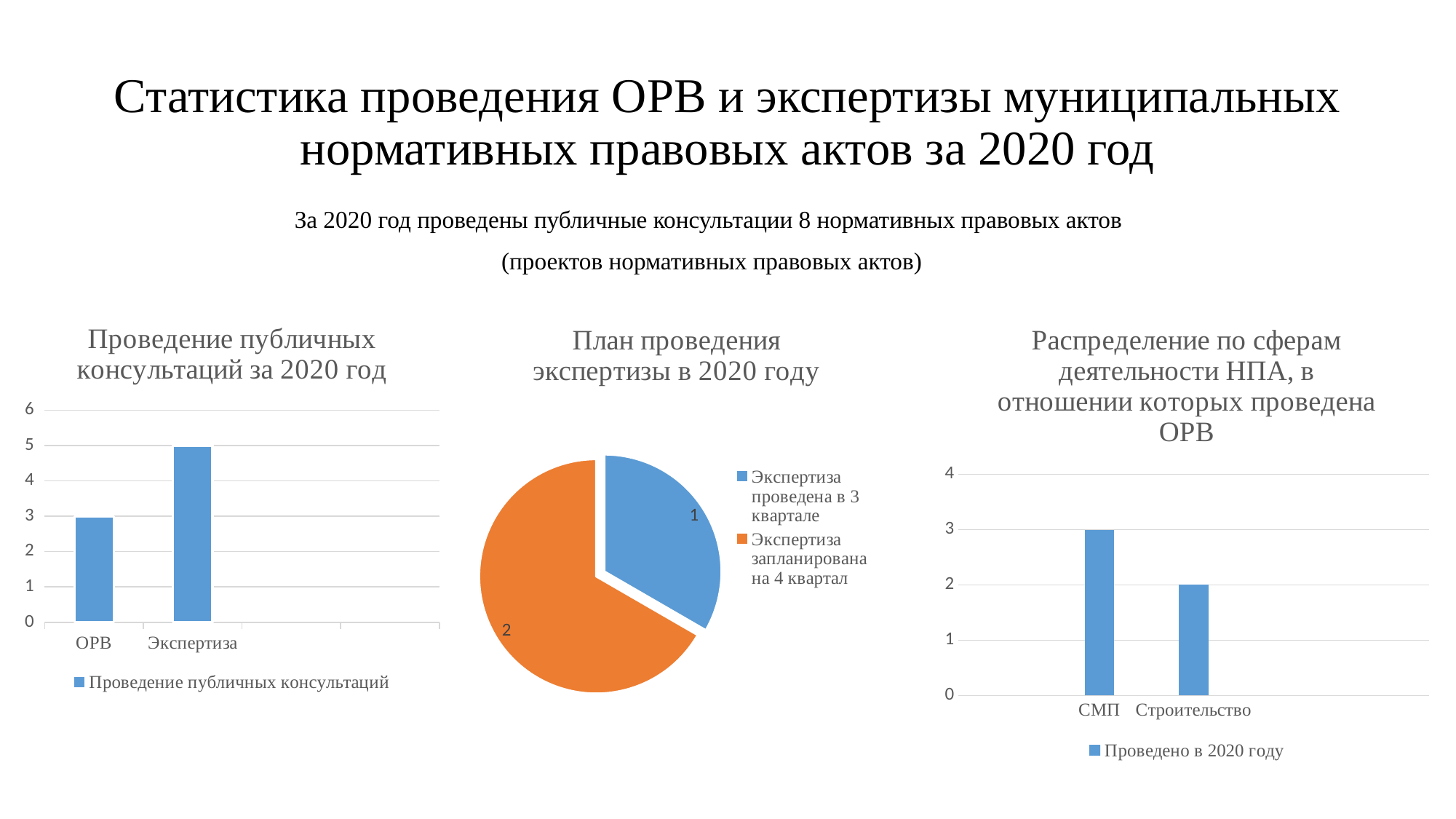
In the chart 'Проведение публичных консультаций за 2020 год', which category has the higher value? Экспертиза In the pie chart 'План проведения экспертизы в 2020 году', what is the value for 'Экспертиза проведена в 3 квартале'? 1 In the pie chart 'План проведения экспертизы в 2020 году', which slice is larger? Экспертиза запланирована на 4 квартал In the chart 'Распределение по сферам деятельности НПА, в отношении которых проведена ОРВ', what is the value for СМП? 3 In the chart 'Проведение публичных консультаций за 2020 год', what is the value for Экспертиза? 5 In the chart 'Распределение по сферам деятельности НПА, в отношении которых проведена ОРВ', what is the value for Строительство? 2 What kind of chart is 'План проведения экспертизы в 2020 году'? pie chart In the chart 'Проведение публичных консультаций за 2020 год', what is the difference between Экспертиза and ОРВ? 2 In the chart 'Проведение публичных консультаций за 2020 год', what is the value for ОРВ? 3 In the pie chart 'План проведения экспертизы в 2020 году', what is the value for 'Экспертиза запланирована на 4 квартал'? 2 In the chart 'Распределение по сферам деятельности НПА, в отношении которых проведена ОРВ', what is the legend entry? Проведено в 2020 году How many slices does the pie chart 'План проведения экспертизы в 2020 году' have? 2